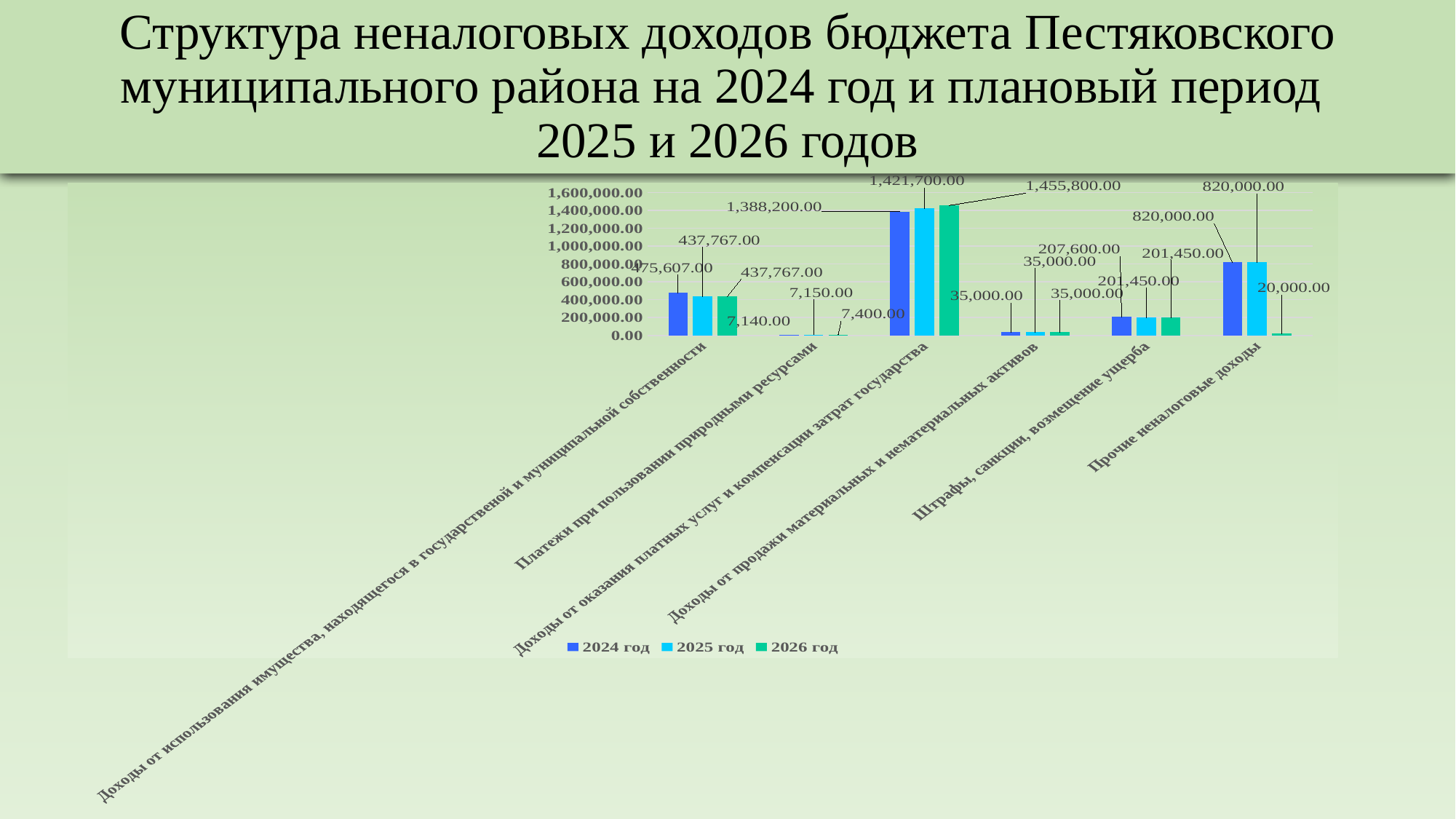
What is the value for 2026 год in the category 'Доходы от оказания платных услуг и компенсации затрат государства'? 1,455,800.00 What kind of chart is shown on the slide? bar chart What is the value for 2024 год in the category 'Доходы от использования имущества, находящегося в государственной и муниципальной собственности'? 475,607.00 In the category 'Прочие неналоговые доходы', which is larger: the value for 2024 год or for 2026 год? 2024 год What is the value for 2024 год in the category 'Доходы от оказания платных услуг и компенсации затрат государства'? 1,388,200.00 How many series does the legend list? 3 What is the difference between the 2026 год and 2024 год values in the category 'Доходы от оказания платных услуг и компенсации затрат государства'? 67,600.00 Which category has the lowest value for 2024 год? Платежи при пользовании природными ресурсами What is the value for 2026 год in the category 'Прочие неналоговые доходы'? 20,000.00 How many categories are shown on the x axis? 6 Do the values for 'Доходы от оказания платных услуг и компенсации затрат государства' rise or fall from 2024 год to 2026 год? rise Which category has the highest value for 2025 год? Доходы от оказания платных услуг и компенсации затрат государства